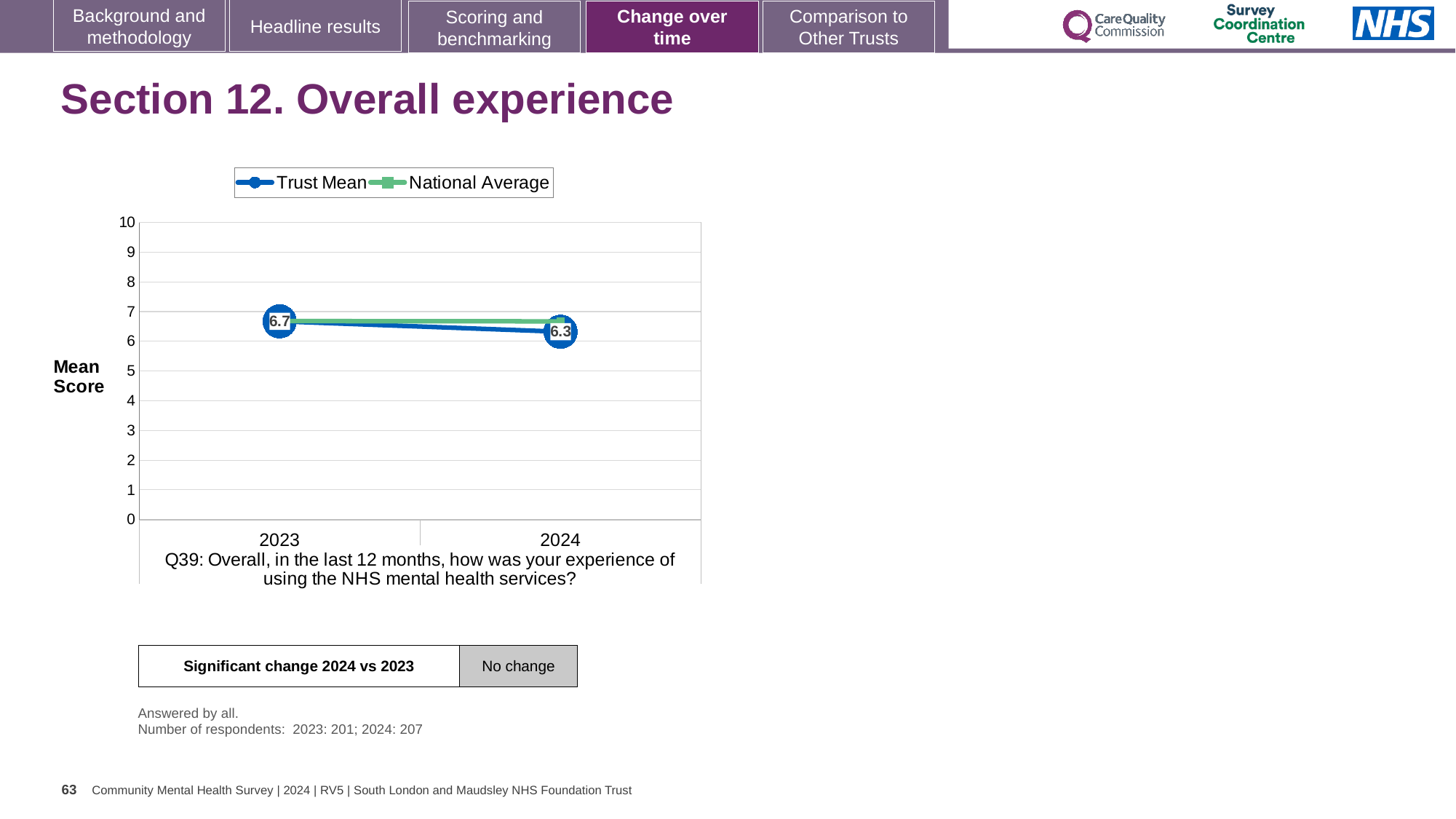
How many years are plotted on the x axis? 2 By how much did the Trust Mean change from 2023 to 2024? 0.4 In which year is the Trust Mean higher, 2023 or 2024? 2023 Is the National Average value for 2024 greater or less than 5? greater What kind of chart is shown on the slide? line chart Does the Trust Mean rise or fall from 2023 to 2024? fall What is the Trust Mean value for 2024? 6.3 Is the National Average value for 2023 greater or less than 8? less What are the two series named in the legend? Trust Mean and National Average How many series does the legend list? 2 What is the Trust Mean value for 2023? 6.7 What is the label on the y axis of the chart? Mean Score